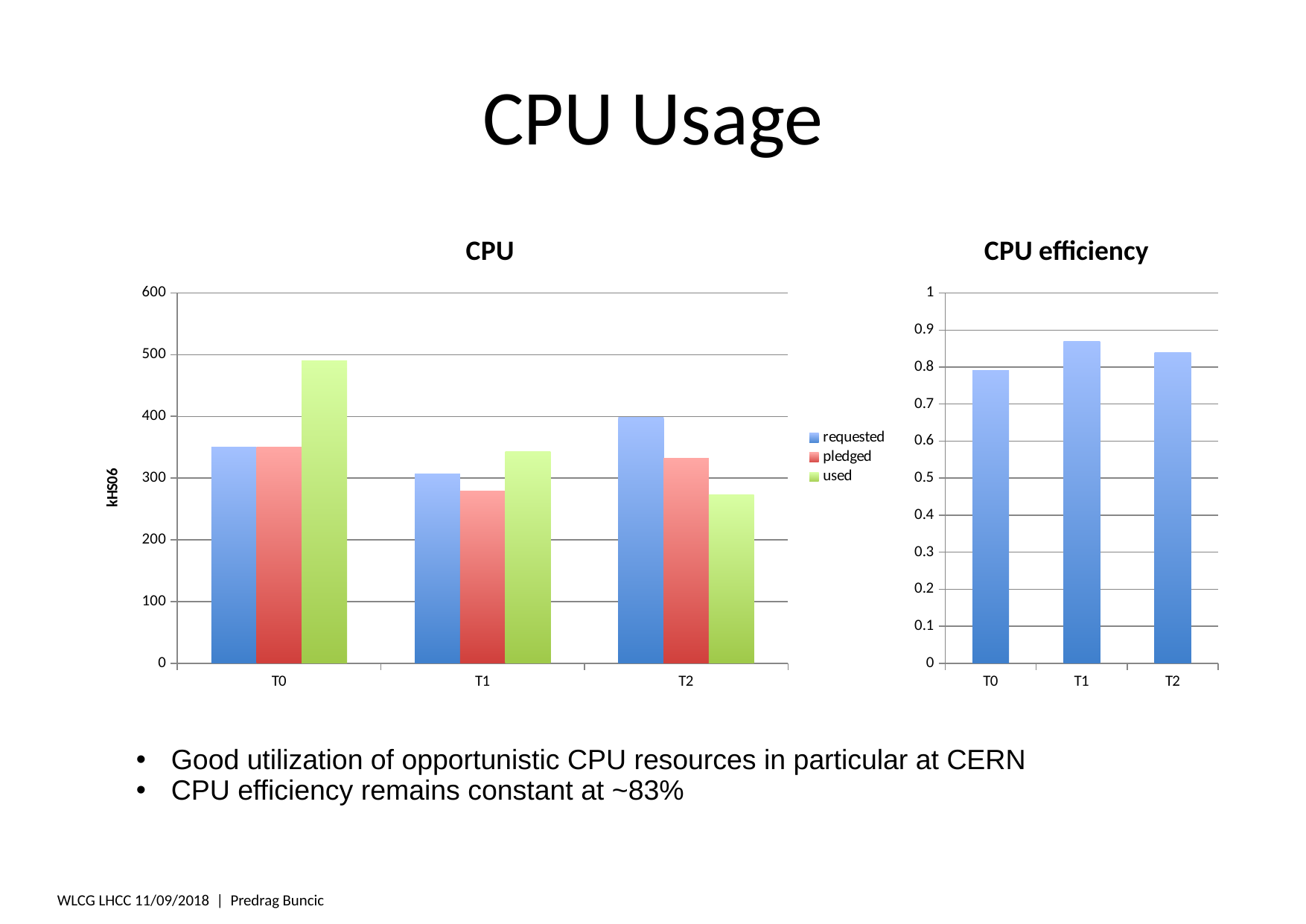
How many categories are shown on the x axis of the CPU chart? 3 In the CPU efficiency chart, is the value for T1 greater or less than 0.9? less What is the y-axis label of the CPU chart? kHS06 In the CPU chart, is the used value for T0 greater or less than 400? greater In the CPU chart, which is larger for T2: requested or used? requested What kind of chart is the CPU chart on the left? bar chart How many series does the legend of the CPU chart list? 3 In the CPU chart, is the pledged value for T1 greater or less than 300? less In the CPU chart, which is larger for T1: used or pledged? used In the CPU chart, which category has the highest used value? T0 In the CPU chart, which category has the lowest used value? T2 In the CPU efficiency chart, which category has the highest value? T1